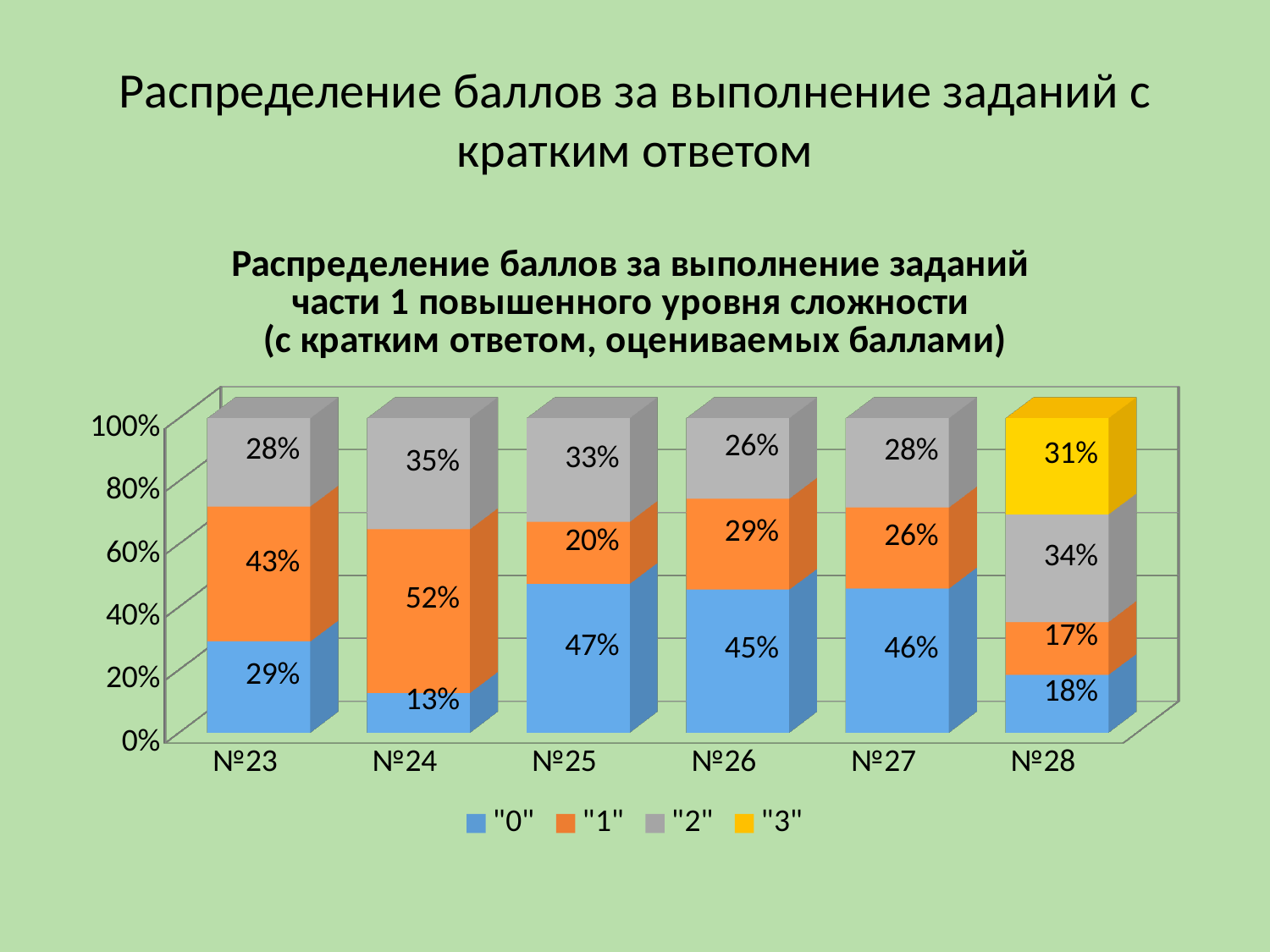
Which is larger: the "2" value for №24 or the "2" value for №25? №24 What is the value of the "1" series for №23? 43% What is the value of the "0" series for №24? 13% How many task categories are shown on the x axis? 6 What is the value of the "2" series for №26? 26% What kind of chart is shown on the slide? stacked bar chart Which task has the highest value for the "1" series? №24 What is the difference between the "0" values for №25 and №28? 29% Which task is the only one with a "3" series segment? №28 How many series does the legend list? 4 Which task has the lowest value for the "0" series? №24 What is the value of the "3" series for №28? 31%